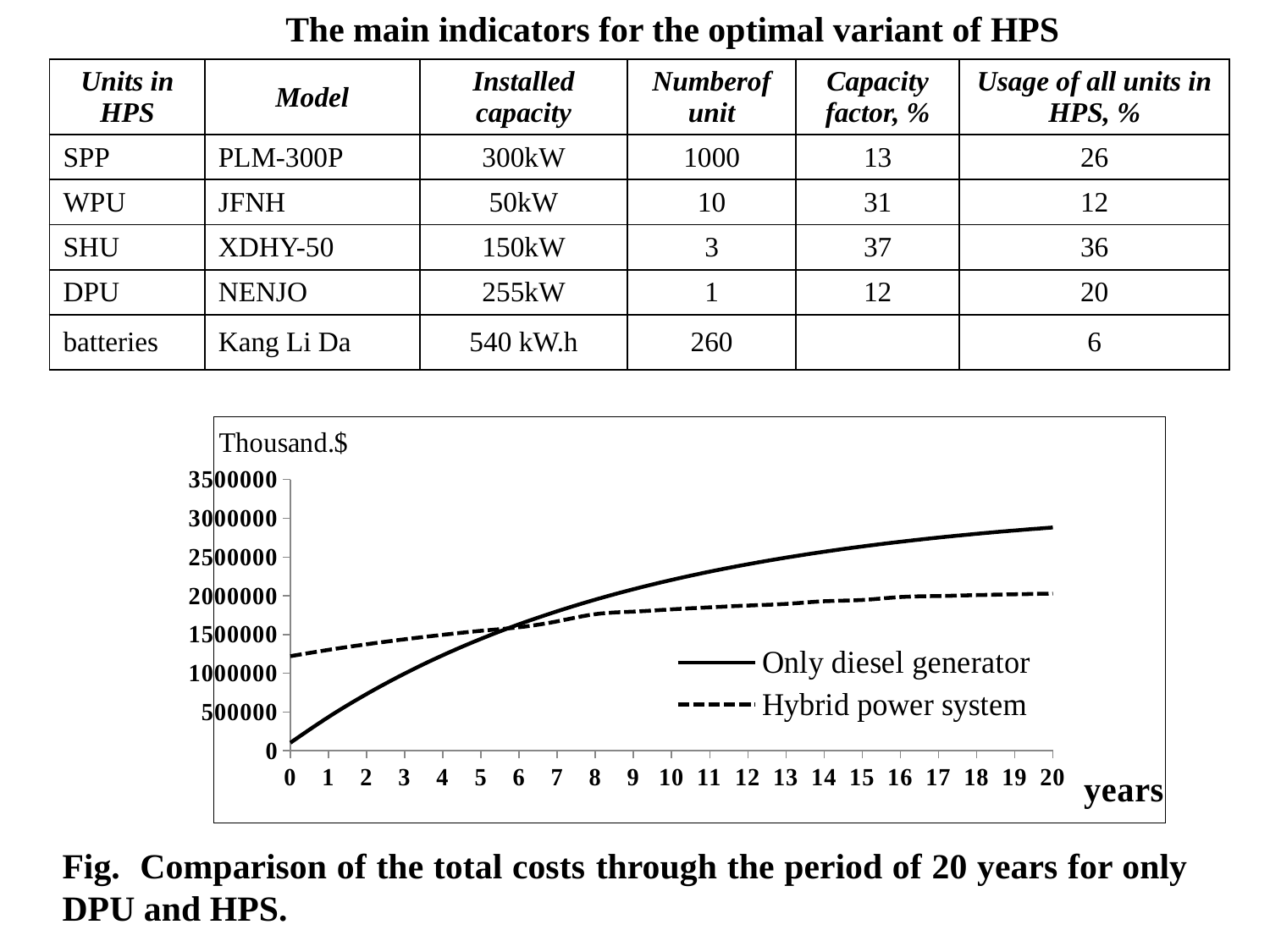
How many series does the chart's legend list? 2 What kind of chart is shown on the slide? line chart Does the 'Hybrid power system' line rise or fall as the years increase? rise Is the value for 'Hybrid power system' at year 0 greater or less than 1000000? greater Which two series are listed in the chart's legend? Only diesel generator; Hybrid power system Is the value for 'Only diesel generator' at year 0 greater or less than 500000? less Is the value for 'Only diesel generator' at year 20 greater or less than 2500000? greater How many year values are marked along the chart's x axis? 21 At year 2, which series has the higher value: 'Only diesel generator' or 'Hybrid power system'? Hybrid power system Does the 'Only diesel generator' line rise or fall as the years increase? rise At year 20, which series has the higher value: 'Only diesel generator' or 'Hybrid power system'? Only diesel generator What unit label is shown at the top of the chart's vertical axis? Thousand.$